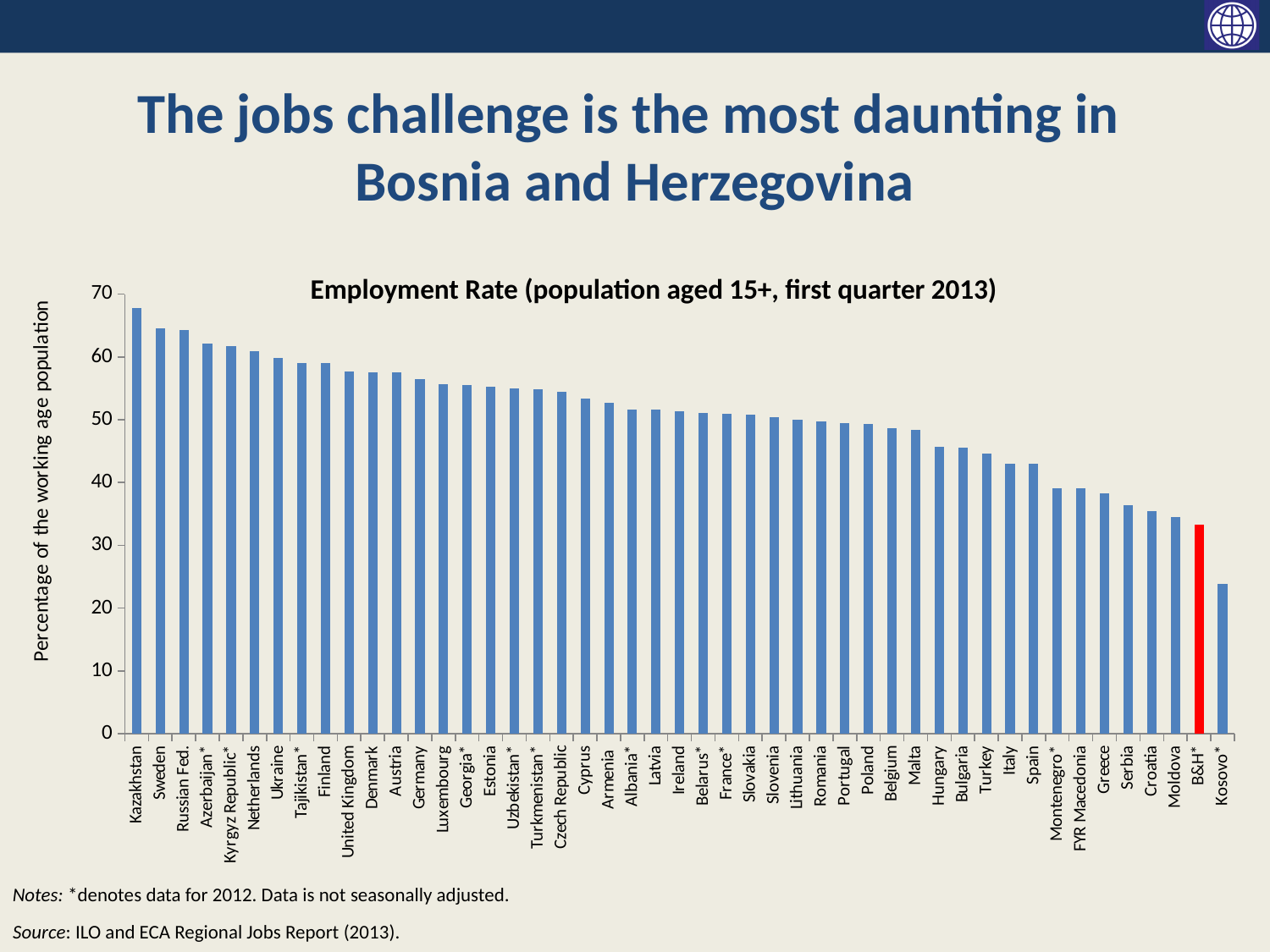
How many countries are shown in the chart? 47 Is the employment rate for Germany greater or less than 50? greater Is the employment rate for Hungary greater or less than 50? less Is the employment rate for B&H* greater or less than 30? greater Which country has the highest employment rate in the chart? Kazakhstan Which has a higher employment rate, Sweden or Greece? Sweden Which bar in the chart is coloured red? B&H* Do the employment rates rise or fall moving from left to right along the x axis? fall Which country has the lowest employment rate in the chart? Kosovo* What kind of chart is shown on the slide? bar chart